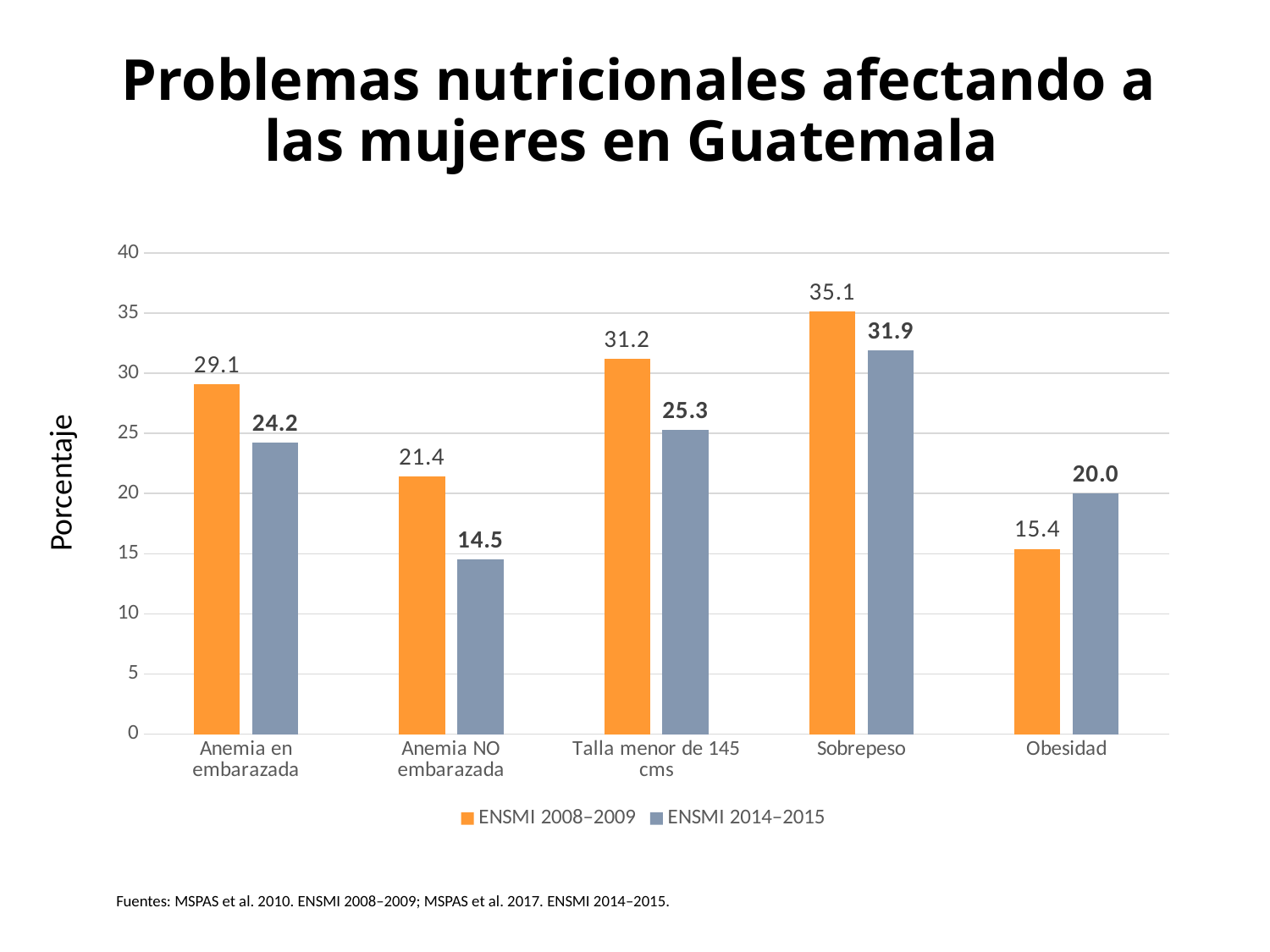
Which is larger for Obesidad: the ENSMI 2008–2009 value or the ENSMI 2014–2015 value? ENSMI 2014–2015 What is the label of the vertical axis? Porcentaje Which category has the lowest ENSMI 2014–2015 value? Anemia NO embarazada How many series does the legend list? 2 Is the ENSMI 2014–2015 value for Talla menor de 145 cms greater or less than 30? less What kind of chart is shown on the slide? bar chart How many categories are shown on the x axis? 5 Which category has the highest ENSMI 2008–2009 value? Sobrepeso What is the difference between the ENSMI 2008–2009 and ENSMI 2014–2015 values for Anemia en embarazada? 4.9 What is the ENSMI 2014–2015 value for Obesidad? 20.0 What is the ENSMI 2008–2009 value for Sobrepeso? 35.1 What is the ENSMI 2014–2015 value for Anemia NO embarazada? 14.5